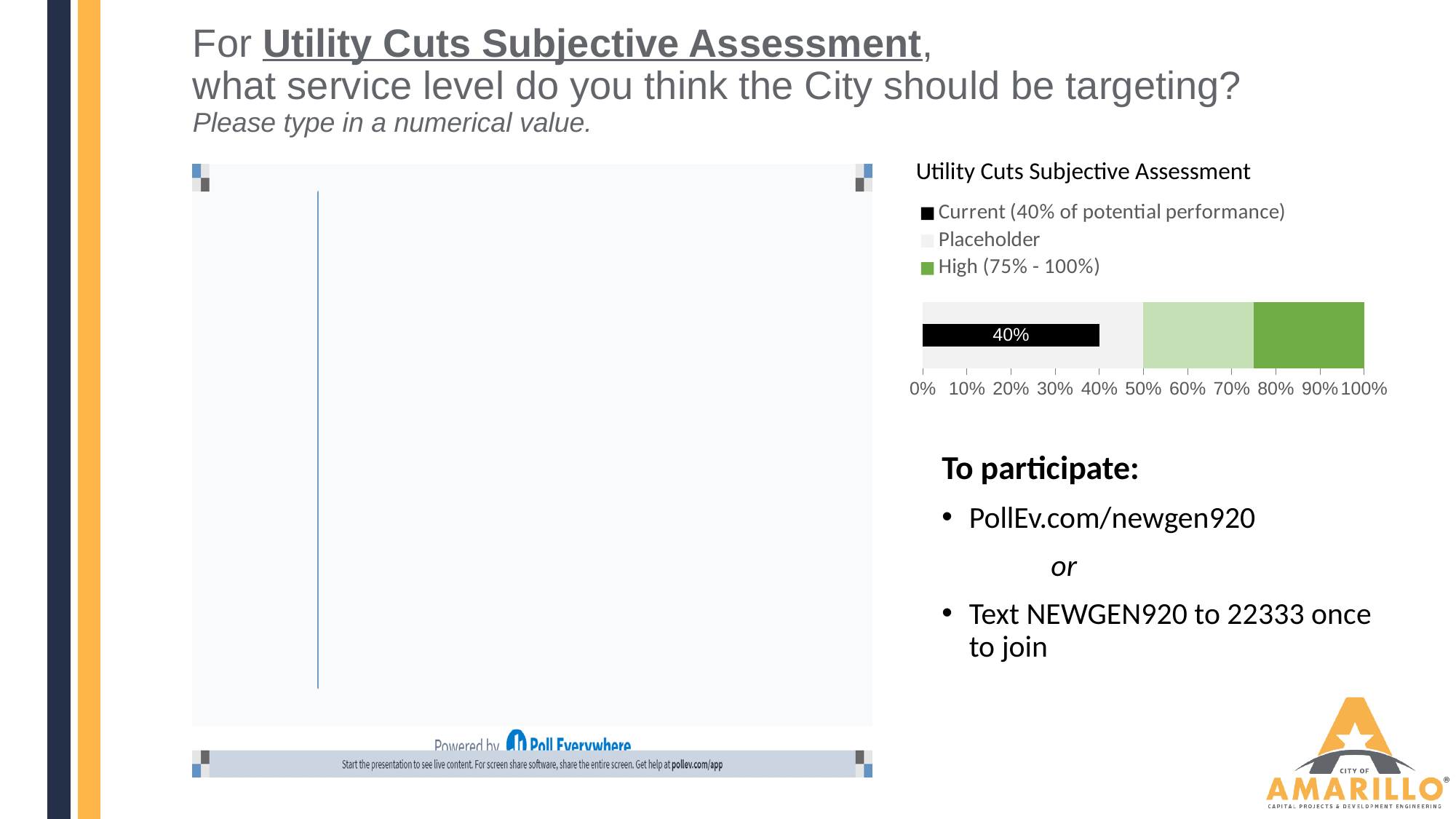
What is the title of the chart on the right side of the slide? Utility Cuts Subjective Assessment What is the lowest tick label on the x axis of the Utility Cuts Subjective Assessment chart? 0% What kind of chart is the Utility Cuts Subjective Assessment chart? bar chart How many series does the legend of the Utility Cuts Subjective Assessment chart list? 3 Is the value of the Current bar in the Utility Cuts Subjective Assessment chart greater or less than 30%? greater According to the legend of the Utility Cuts Subjective Assessment chart, what range does the High series cover? 75% - 100% What value is printed on the Current bar in the Utility Cuts Subjective Assessment chart? 40% What is the highest tick label on the x axis of the Utility Cuts Subjective Assessment chart? 100% Is the value of the Current bar in the Utility Cuts Subjective Assessment chart greater or less than 50%? less